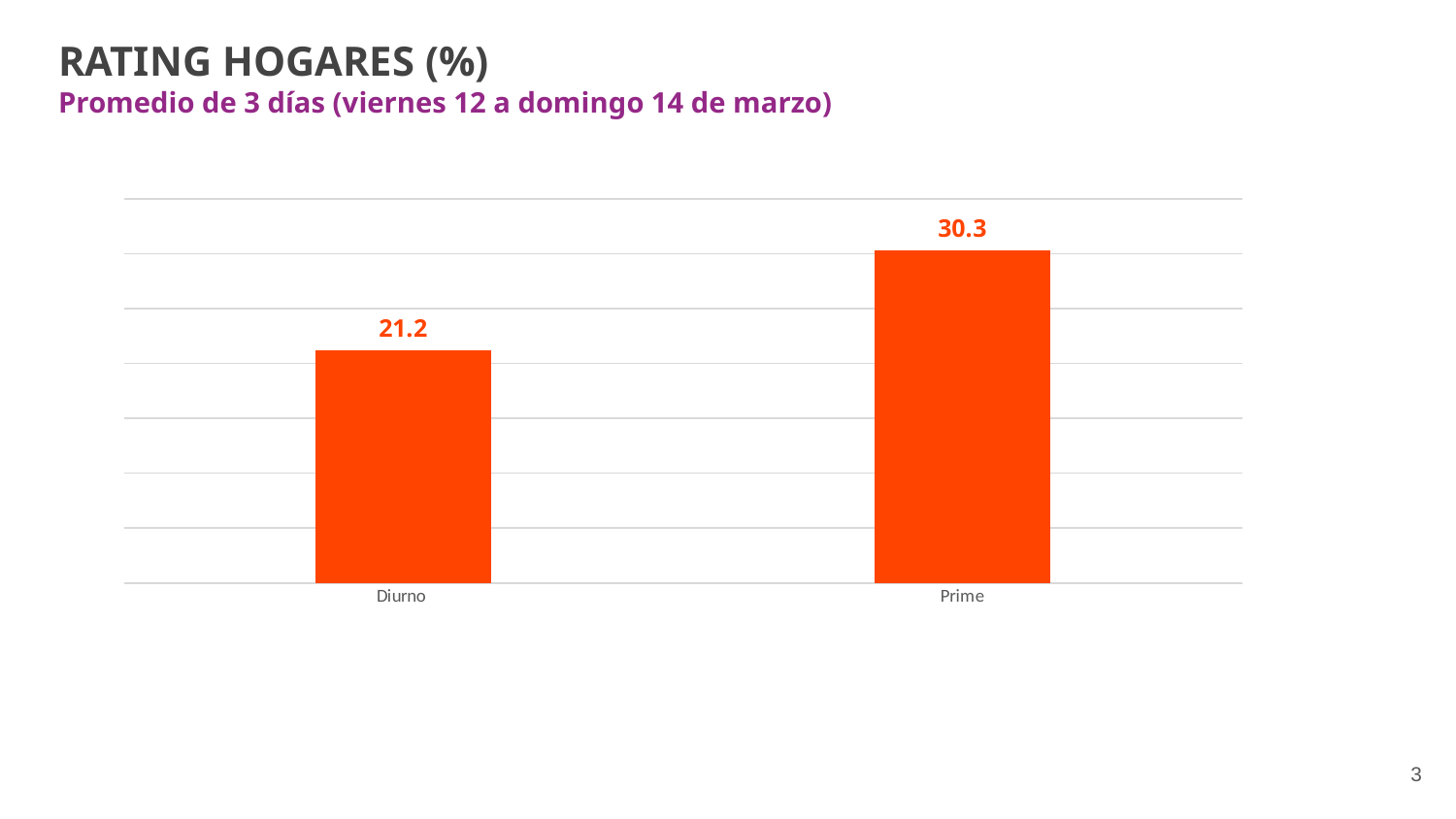
Which category has the highest value? Prime What is the title of the slide? RATING HOGARES (%) Do the values rise or fall from Diurno to Prime? Rise What is the value for Prime? 30.3 Which is larger, the value for Diurno or the value for Prime? Prime What colour are the bars in the chart? Orange What is the value for Diurno? 21.2 What kind of chart is shown on the slide? Bar chart How many categories are shown in the chart? 2 Which category has the lowest value? Diurno What is the difference between the values for Prime and Diurno? 9.1